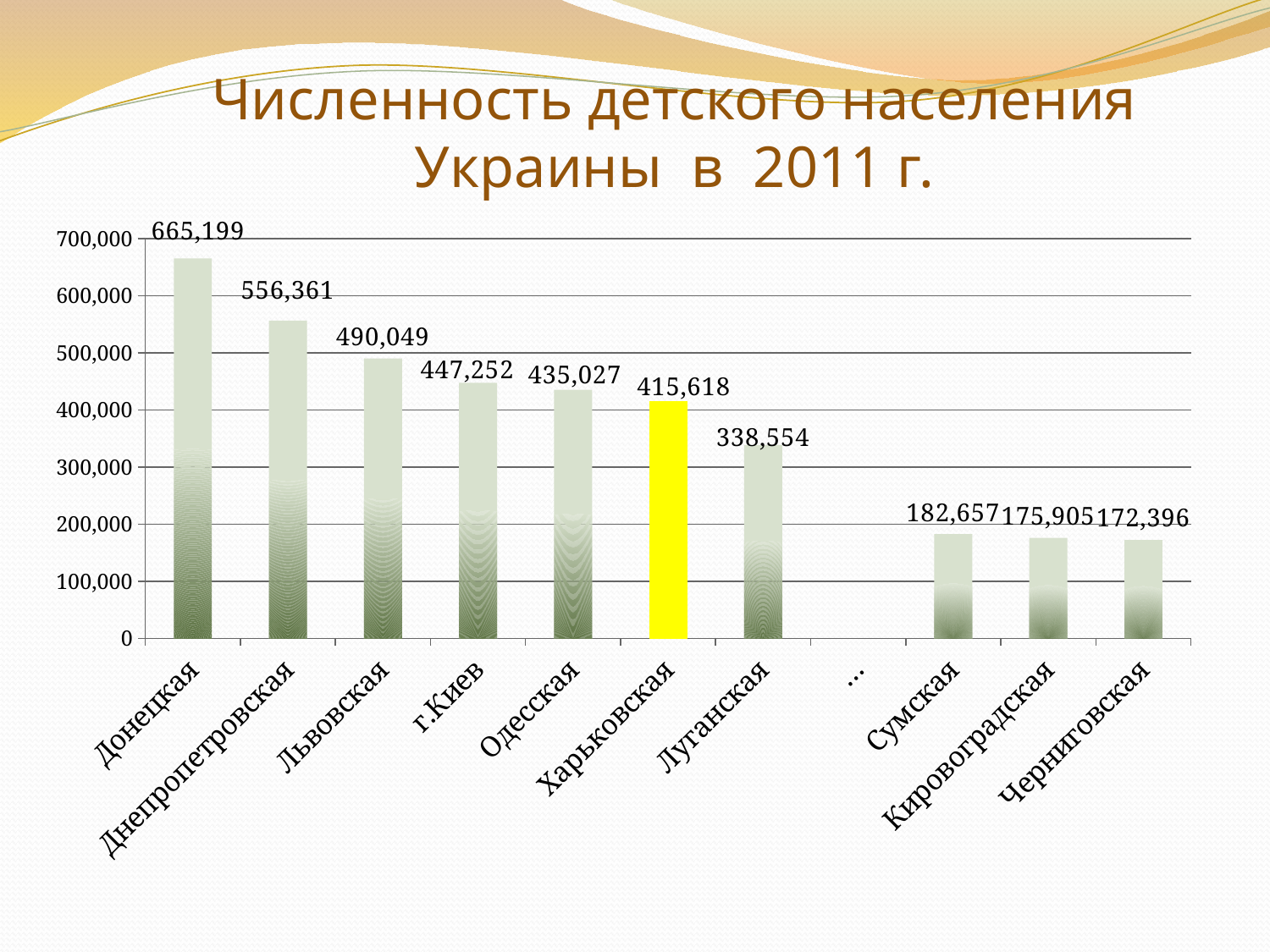
What is the difference between the values for Донецкая and Днепропетровская? 108,838 Is the value for Луганская greater or less than 300,000? greater How many regions have a bar plotted on the chart? 10 What is the value for Черниговская? 172,396 What is the value for Донецкая? 665,199 What is the difference between the values for Харьковская and Луганская? 77,064 What kind of chart is shown on the slide? bar chart Which region has the highest value? Донецкая What is the value for Харьковская? 415,618 Which is larger, the value for г.Киев or the value for Одесская? г.Киев Which region has the lowest value? Черниговская Which bar is highlighted in yellow? Харьковская